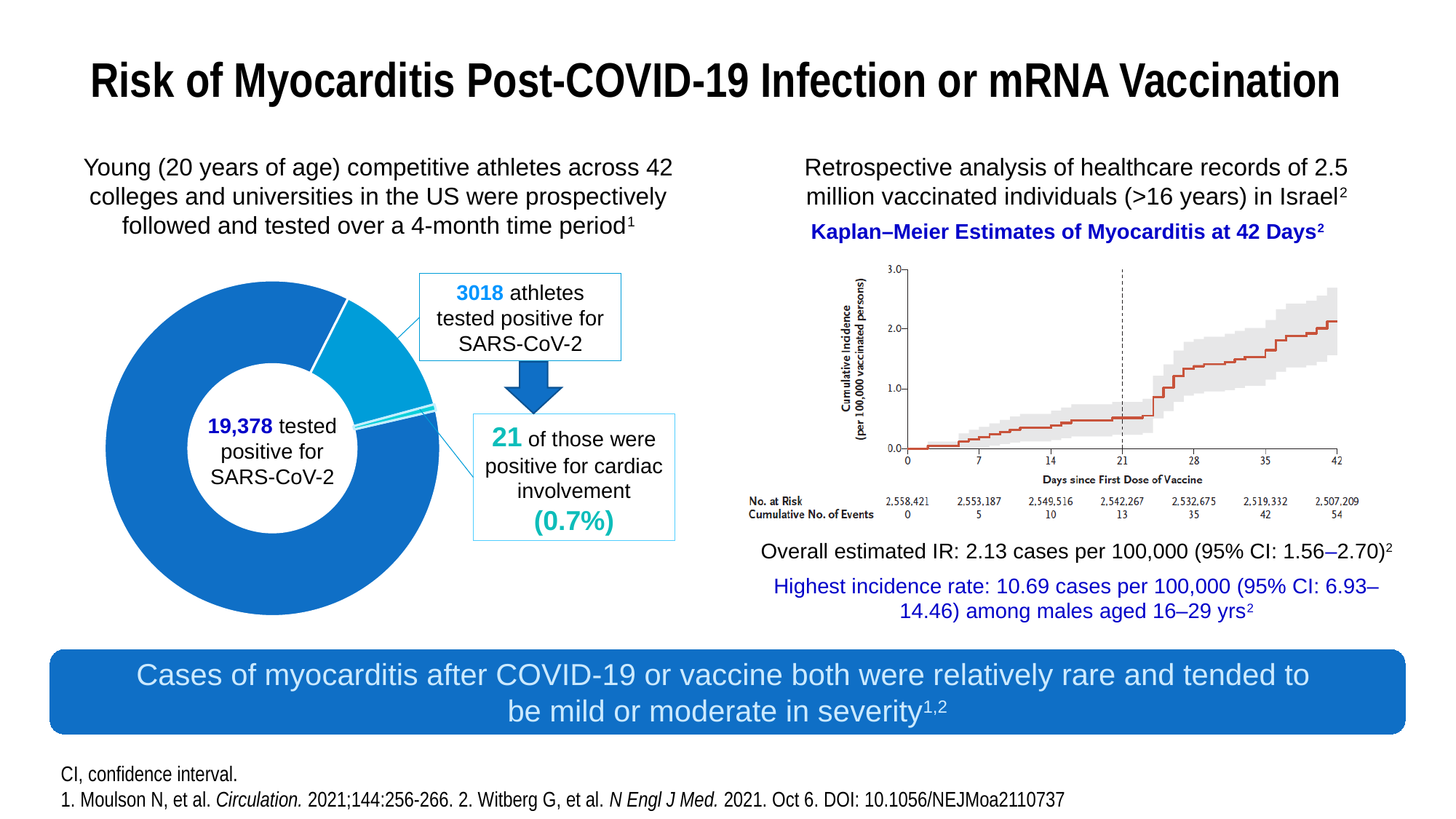
What kind of chart is shown on the left side of the slide? Donut (pie) chart In the donut chart on the left, how many athletes tested positive for SARS-CoV-2 according to the callout box? 3018 What kind of chart is the Kaplan–Meier Estimates of Myocarditis at 42 Days chart? Line chart In the donut chart on the left, what percentage is shown for those positive for cardiac involvement? 0.7% In the Kaplan–Meier chart, what is the cumulative number of events at day 42? 54 In the Kaplan–Meier chart, does the cumulative incidence rise or fall as days since first dose increase? Rises What is the x-axis label of the Kaplan–Meier chart? Days since First Dose of Vaccine In the Kaplan–Meier chart, is the cumulative incidence at day 42 greater or less than 2.0? greater In the Kaplan–Meier chart, what is the number at risk at day 0? 2,558,421 In the donut chart on the left, how many of the positive athletes were positive for cardiac involvement? 21 In the Kaplan–Meier chart, what is the difference in the cumulative number of events between day 28 and day 21? 22 In the Kaplan–Meier chart, is the cumulative incidence at day 21 greater or less than 1.0? less